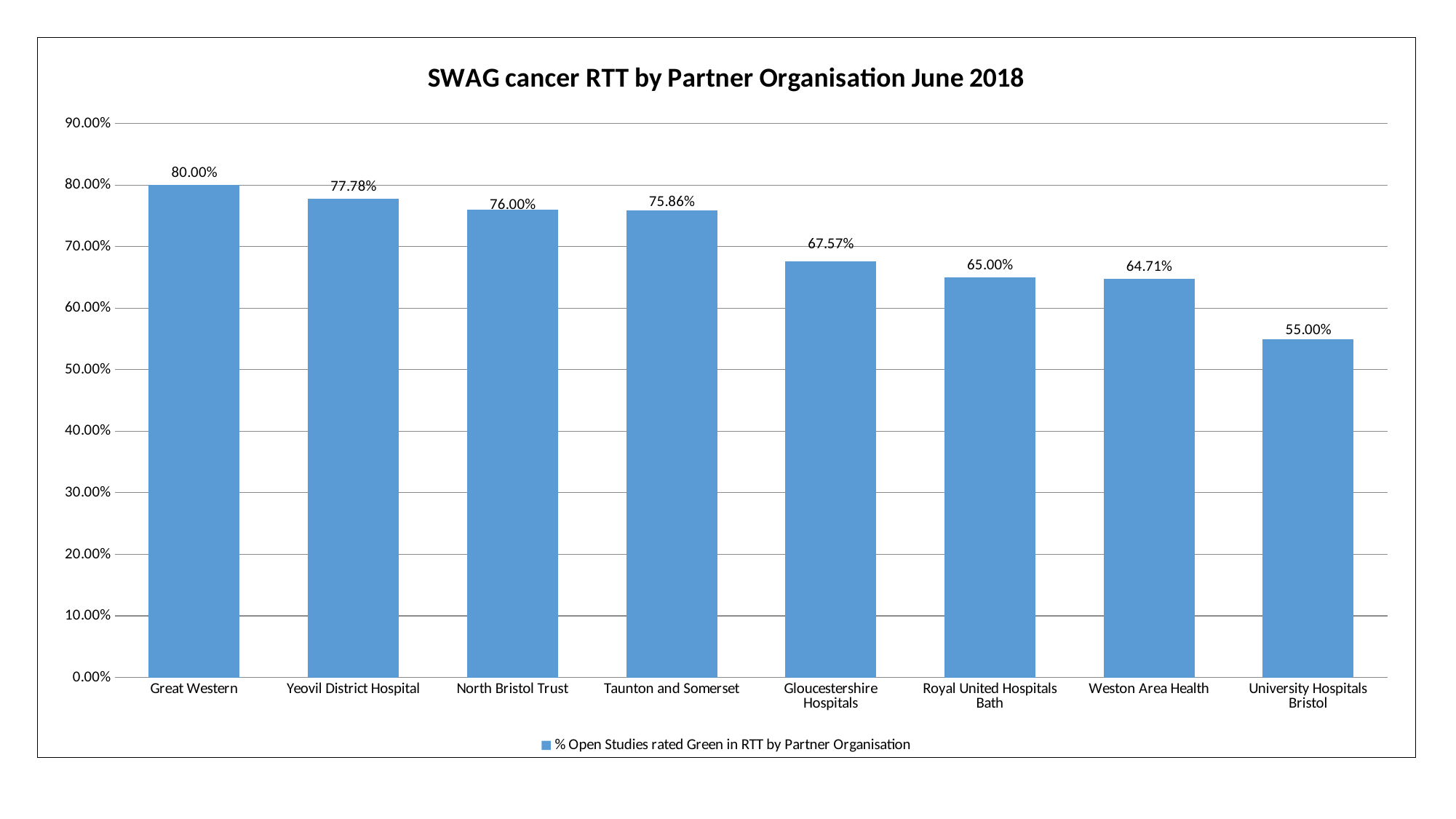
What is the title of the chart? SWAG cancer RTT by Partner Organisation June 2018 What is the difference between the values for Great Western and University Hospitals Bristol? 25.00% What is the value for Great Western? 80.00% Is the value for Taunton and Somerset greater or less than 70.00%? greater What is the value for Weston Area Health? 64.71% What is the value for Gloucestershire Hospitals? 67.57% Which partner organisation has the lowest value? University Hospitals Bristol What kind of chart is shown on the slide? Bar chart What is the difference between the values for Yeovil District Hospital and Royal United Hospitals Bath? 12.78% How many partner organisations are shown on the chart? 8 Which is larger, the value for Gloucestershire Hospitals or the value for Weston Area Health? Gloucestershire Hospitals Which partner organisation has the highest value? Great Western